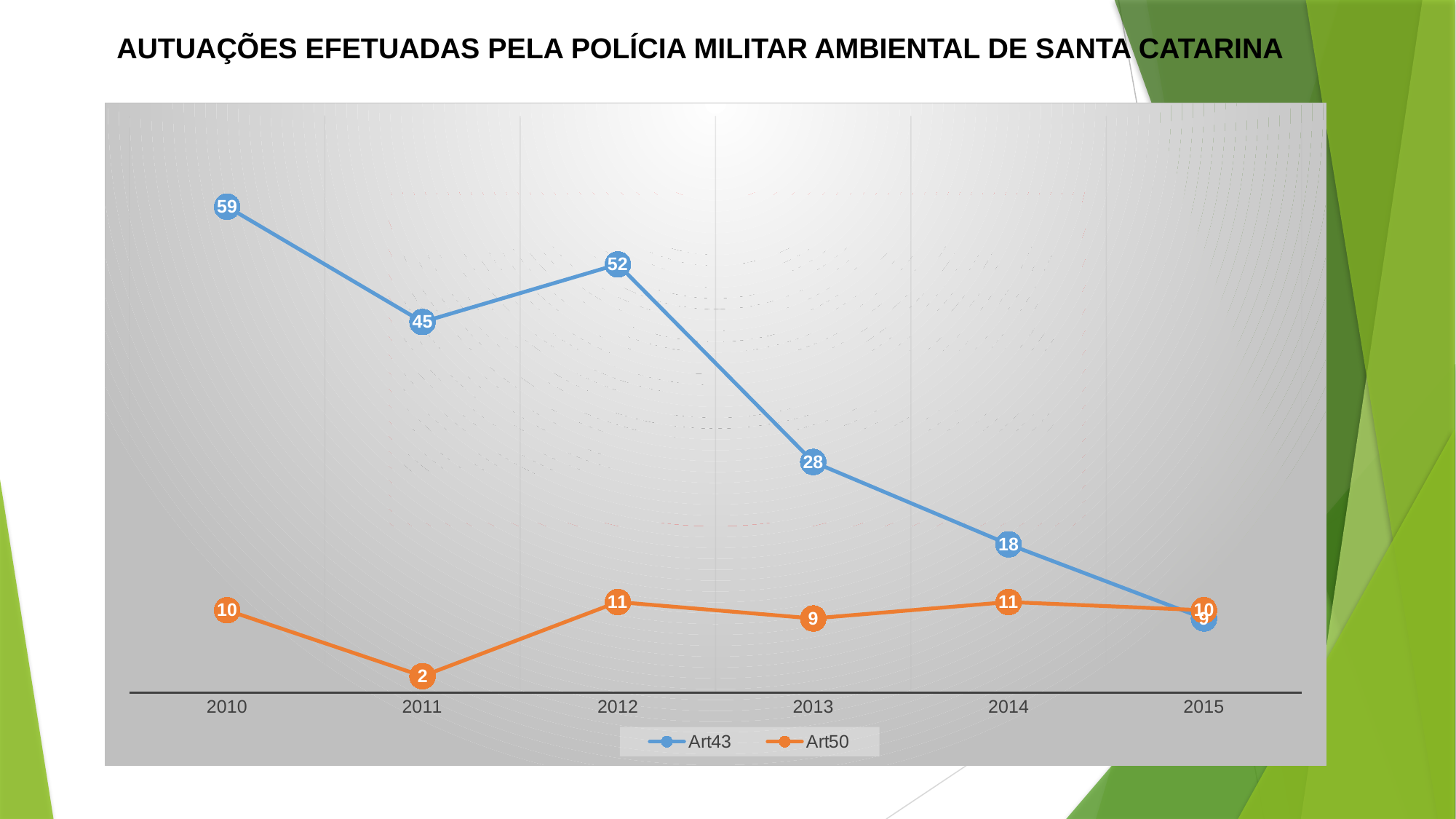
What is the value for Art43 in 2013? 28 In 2012, which series has the larger value, Art43 or Art50? Art43 What is the difference between the Art43 values for 2010 and 2011? 14 In which year is the Art50 value lowest? 2011 Does the Art43 line rise or fall from 2012 to 2014? fall How many years are plotted along the x axis? 6 What is the value for Art43 in 2010? 59 How many series does the legend list? 2 What kind of chart is shown on the slide? line chart In which year is the Art43 value highest? 2010 What is the value for Art50 in 2011? 2 What is the value for Art50 in 2014? 11